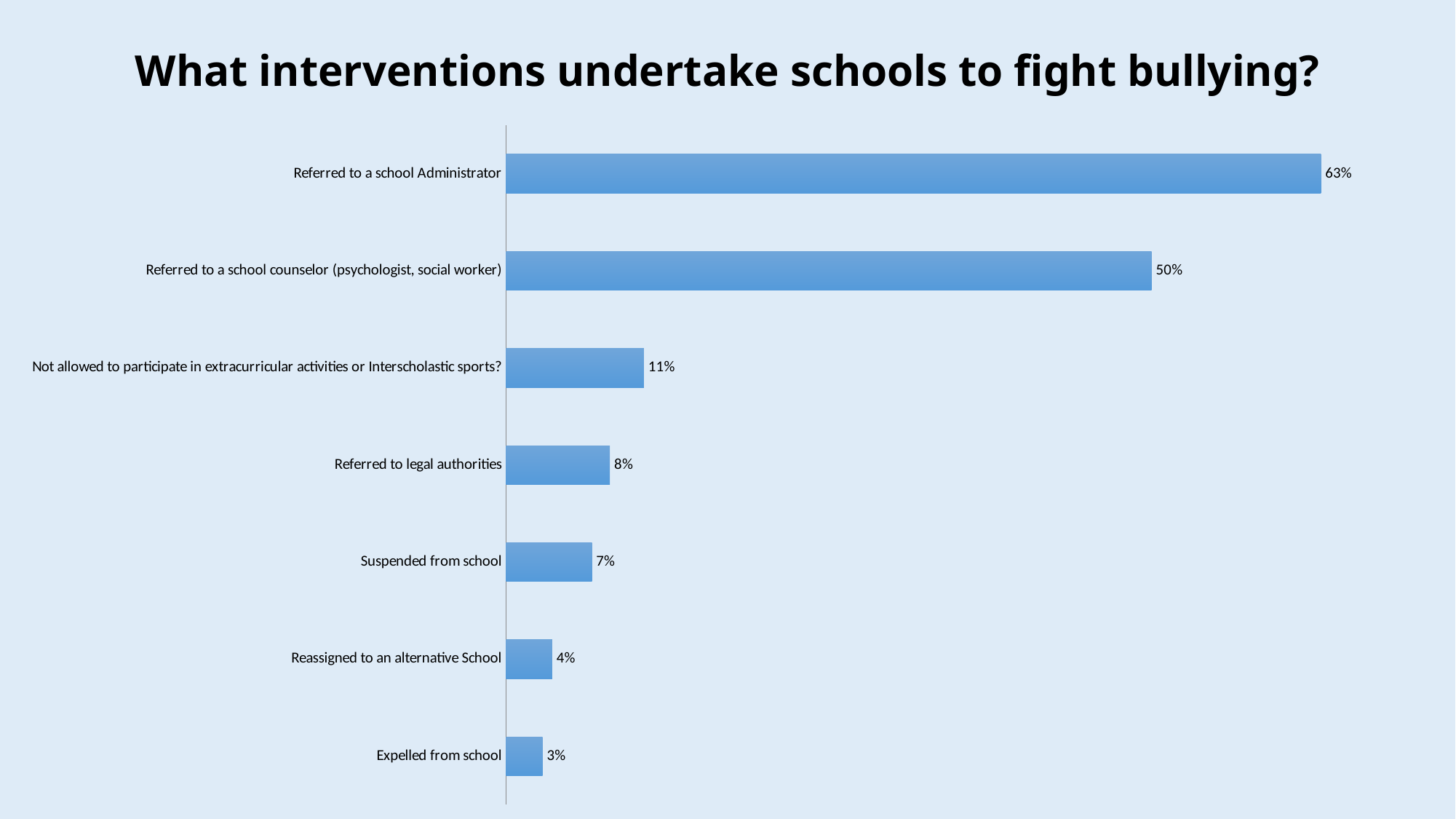
What is the value for 'Referred to a school counselor (psychologist, social worker)'? 50% What is the value for 'Expelled from school'? 3% What kind of chart is shown on the slide? Bar chart What percentage of interventions is 'Referred to a school Administrator'? 63% Which intervention has the highest value? Referred to a school Administrator What is the difference between 'Referred to a school Administrator' and 'Referred to a school counselor (psychologist, social worker)'? 13% What is the title of the slide? What interventions undertake schools to fight bullying? What is the difference between 'Not allowed to participate in extracurricular activities or Interscholastic sports?' and 'Referred to legal authorities'? 3% What is the value for 'Suspended from school'? 7% Which intervention has the lowest value? Expelled from school Which is larger: 'Suspended from school' or 'Reassigned to an alternative School'? Suspended from school How many intervention categories are shown in the chart? 7